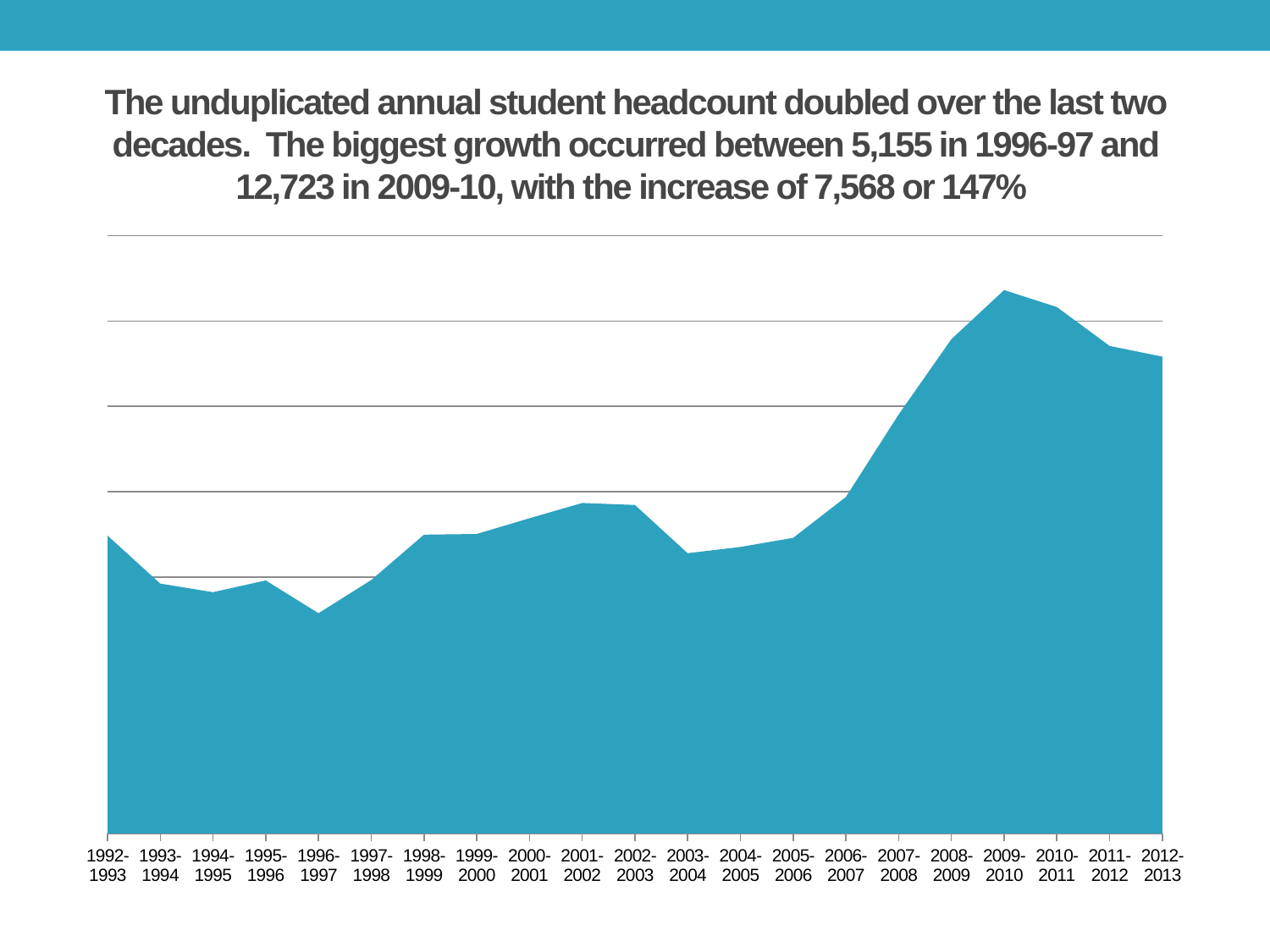
How many academic years are plotted along the x axis? 21 What is the increase in headcount between 1996-97 and 2009-10? 7,568 According to the slide, what was the student headcount in 2009-10? 12,723 Is the headcount higher in 2001-2002 or in 2003-2004? 2001-2002 Which academic year has the lowest student headcount? 1996-1997 According to the slide, what was the student headcount in 1996-97? 5,155 Does the headcount rise or fall from 2009-2010 to 2012-2013? fall Is the headcount higher in 1992-1993 or in 1993-1994? 1992-1993 What kind of chart is shown on the slide? area chart Which academic year has the highest student headcount? 2009-2010 What is the first academic year shown on the x axis? 1992-1993 Does the headcount rise or fall from 2005-2006 to 2009-2010? rise